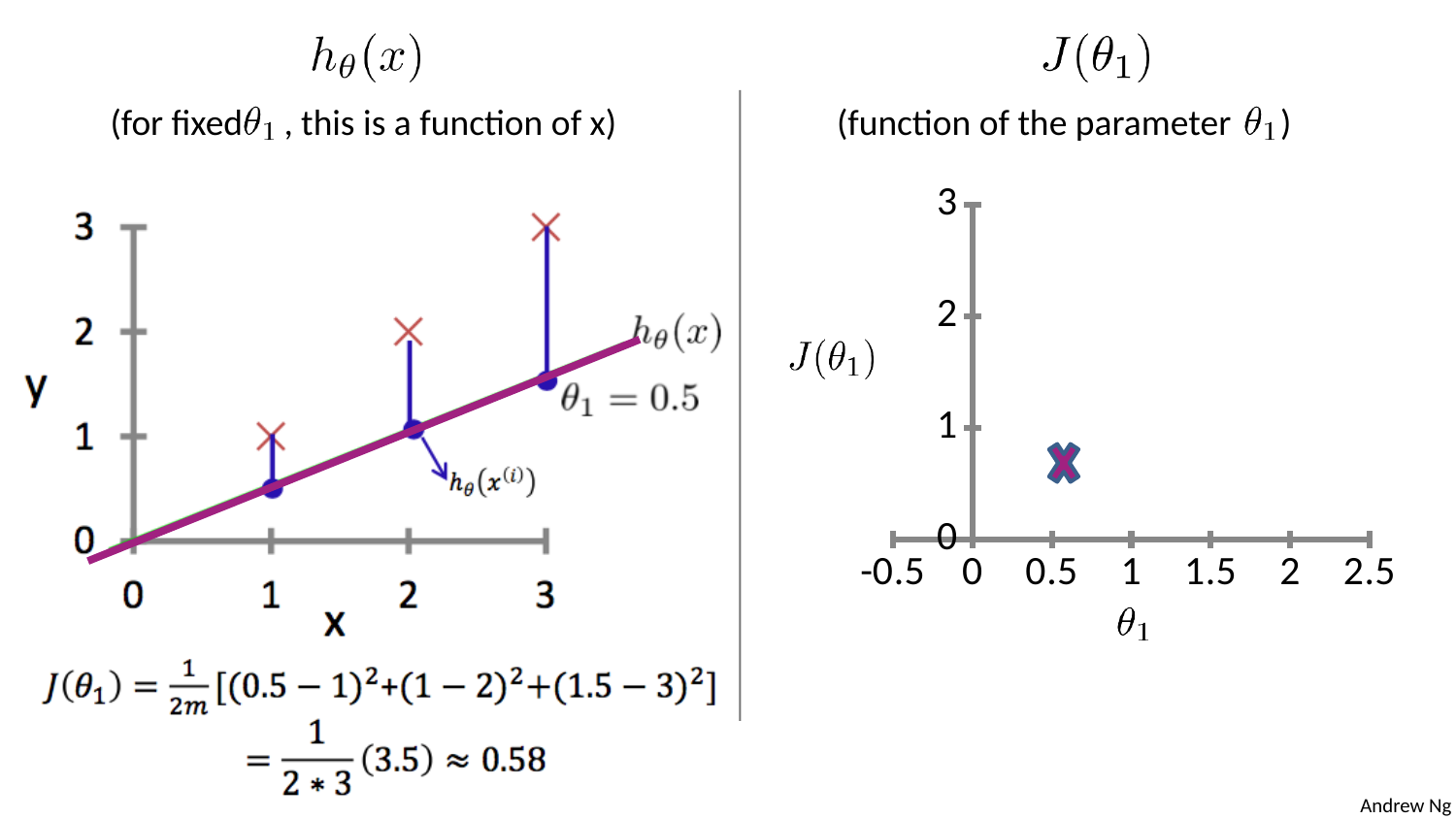
On the left chart h_θ(x), which red cross has the highest y value, the one at x = 1, x = 2 or x = 3? x = 3 On the right chart J(θ1), is the value of the plotted point greater or less than 1? less On the right chart J(θ1), what is the largest tick value shown on the horizontal axis? 2.5 On the left chart h_θ(x), what is the y value of the red cross at x = 1? 1 On the left chart h_θ(x), what value of θ1 is given for the plotted line? 0.5 On the left chart h_θ(x), what is the y value of the red cross at x = 3? 3 On the left chart h_θ(x), how many red cross data points are plotted? 3 On the left chart h_θ(x), what is the difference between the y values of the red crosses at x = 3 and x = 1? 2 On the left chart h_θ(x), do the red cross data points rise or fall as x increases? rise On the right chart J(θ1), what is the label of the horizontal axis? θ1 On the right chart J(θ1), how many points are plotted? 1